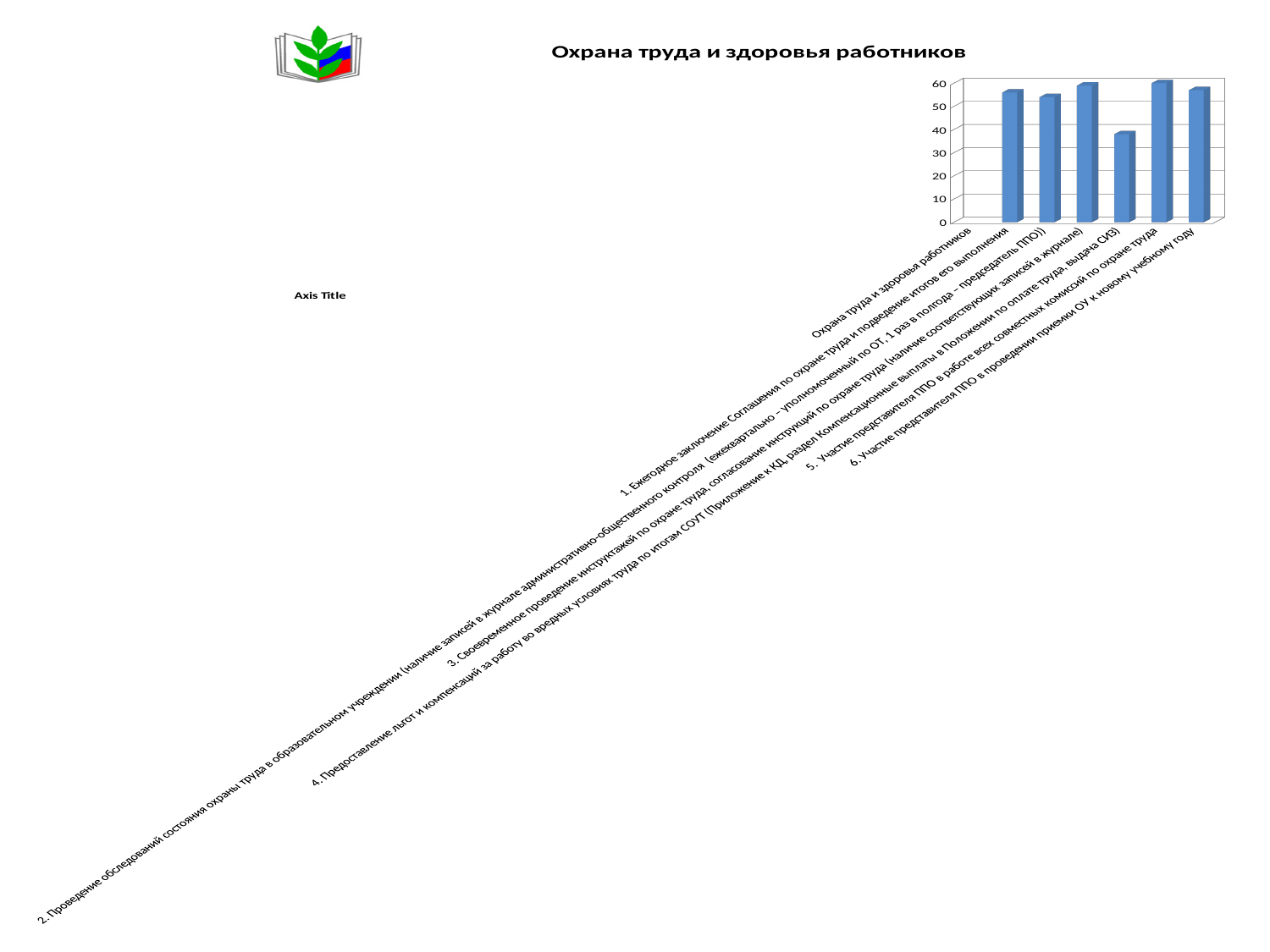
Is the value for category 2 (Проведение обследований состояния охраны труда) greater or less than 40? greater What is the highest tick value shown on the vertical axis? 60 Is the value for category 4 (Предоставление льгот и компенсаций) greater or less than 40? less How many bars (categories) does the chart show? 6 Is the value for category 3 (Своевременное проведение инструктажей) greater or less than 50? greater Which category has the lowest bar? 4. Предоставление льгот и компенсаций за работу во вредных условиях труда Which is larger: the value for category 4 (Предоставление льгот и компенсаций) or category 3 (Своевременное проведение инструктажей)? category 3 What kind of chart is shown on the slide? bar chart What is the title of the chart? Охрана труда и здоровья работников